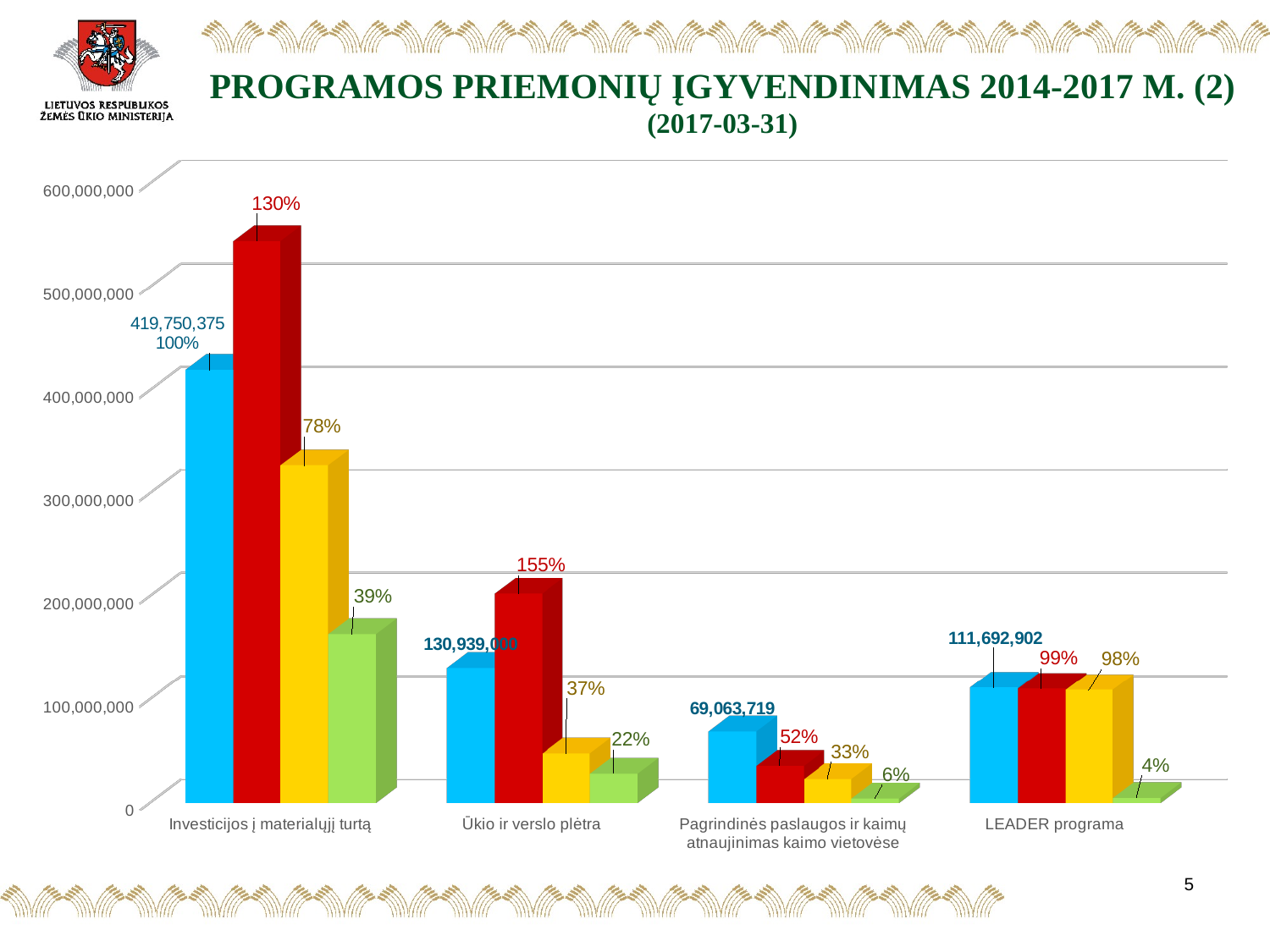
Is the red bar for Investicijos į materialųjį turtą greater or less than 500,000,000? greater What percentage is labelled on the red bar for Ūkio ir verslo plėtra? 155% How many categories are shown on the x axis of the chart? 4 Which category has the tallest blue bar? Investicijos į materialųjį turtą What is the difference between the blue bar values for LEADER programa and Pagrindinės paslaugos ir kaimų atnaujinimas kaimo vietovėse? 42,629,183 What percentage is labelled on the green bar for LEADER programa? 4% What value is labelled on the blue bar for LEADER programa? 111,692,902 What kind of chart is shown on the slide? bar chart Which has the larger blue bar value: LEADER programa or Pagrindinės paslaugos ir kaimų atnaujinimas kaimo vietovėse? LEADER programa What value is labelled on the blue bar for Pagrindinės paslaugos ir kaimų atnaujinimas kaimo vietovėse? 69,063,719 What value is labelled on the blue bar for Investicijos į materialųjį turtą? 419,750,375 What percentage is labelled on the yellow bar for Investicijos į materialųjį turtą? 78%